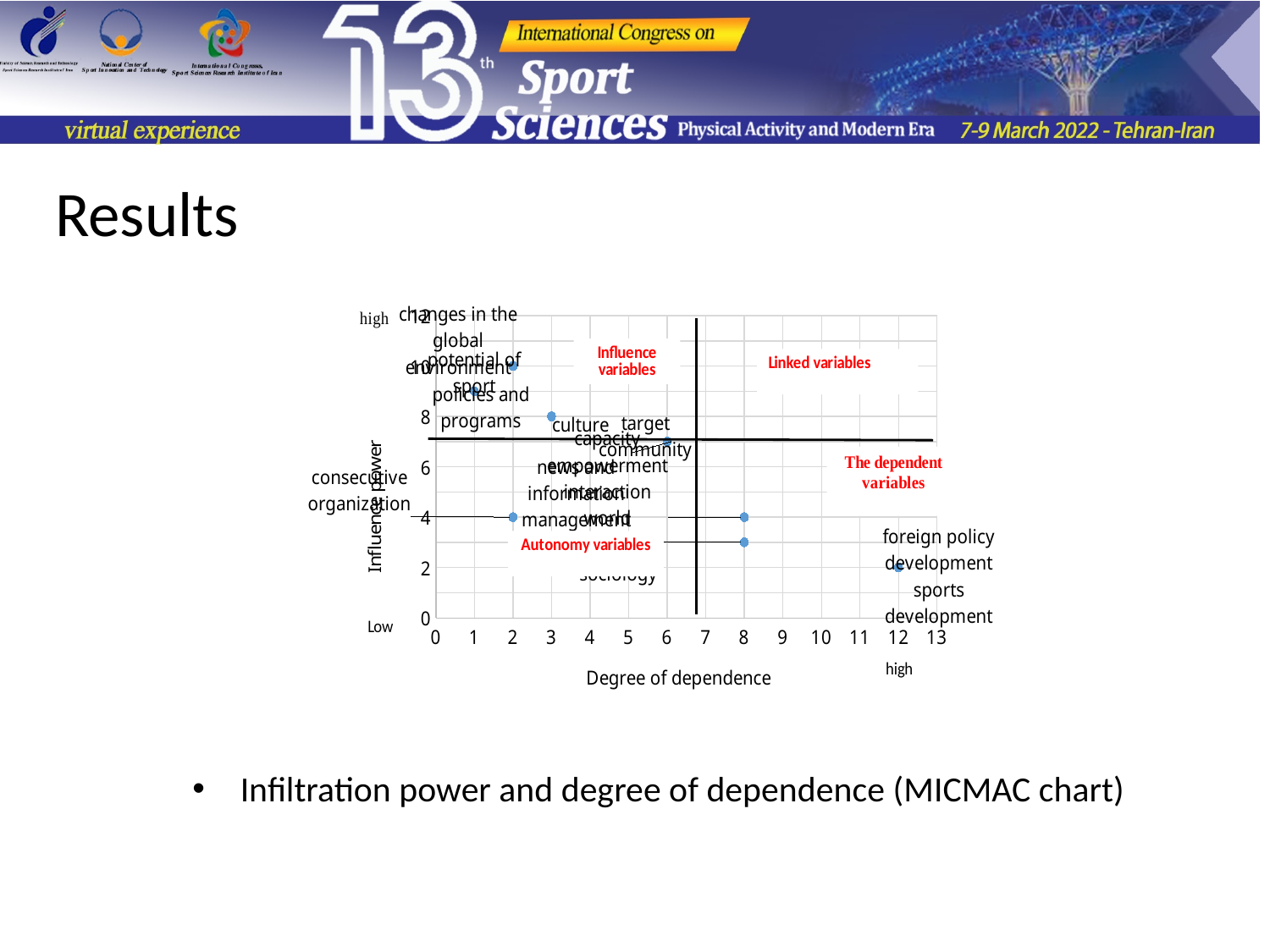
What is the title of the horizontal axis of the chart? Degree of dependence What is the largest value shown on the horizontal axis of the chart? 13 What is the title of the vertical axis of the chart? Influence power Is the degree of dependence of the rightmost point on the chart greater or less than 10? greater Is the influence power of the rightmost point on the chart greater or less than 4? less Is the influence power of the highest point on the chart greater or less than 8? greater What kind of chart is shown on the slide? scatter chart What is the largest value shown on the vertical axis of the chart? 12